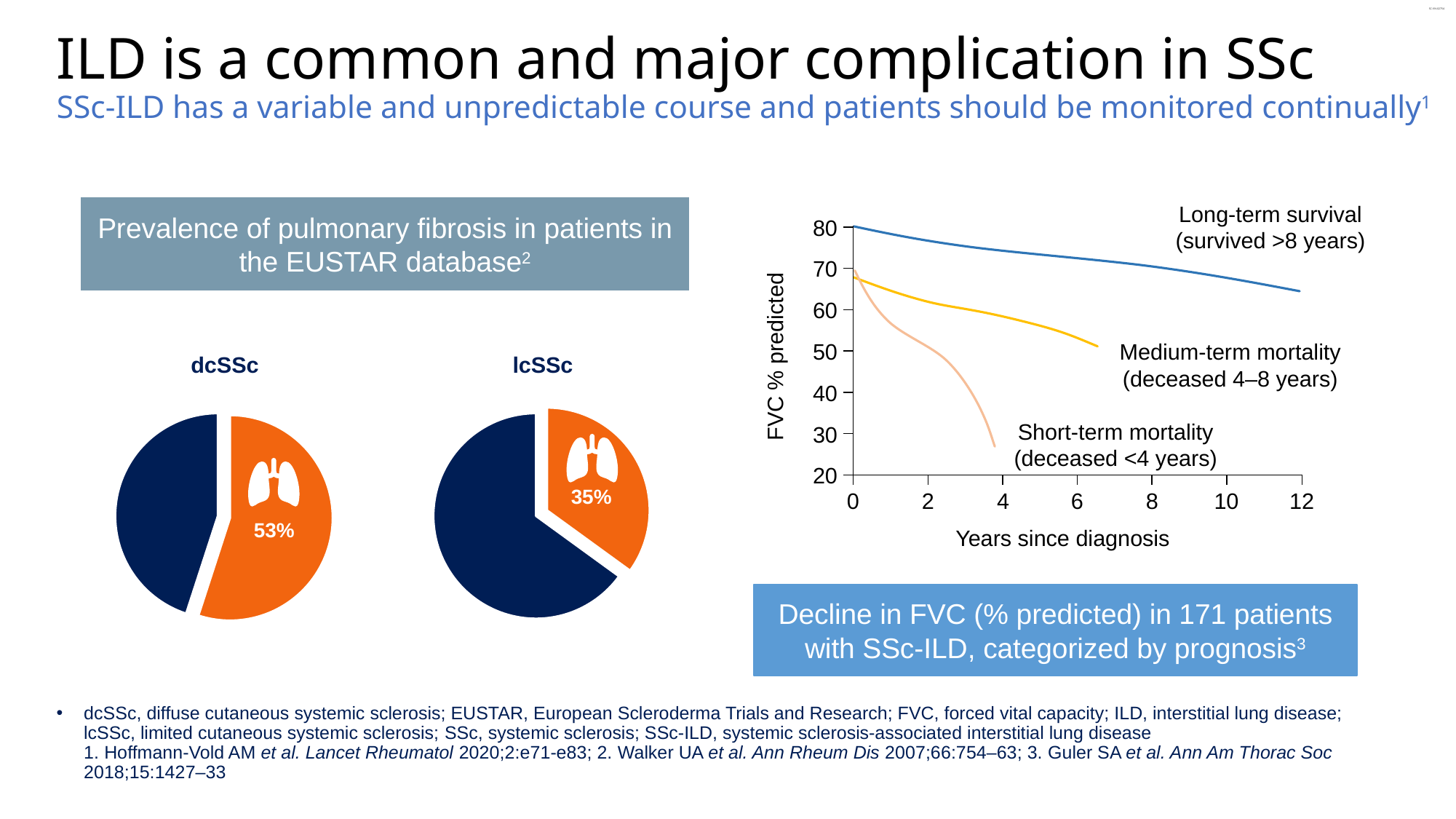
In the lcSSc pie chart, what percentage of patients have pulmonary fibrosis? 35% Which group has the higher prevalence of pulmonary fibrosis in the EUSTAR database pie charts, dcSSc or lcSSc? dcSSc What is the x-axis label of the FVC decline chart? Years since diagnosis How many prognosis groups (curves) are plotted in the FVC decline chart? 3 In the FVC decline chart, which prognosis group has the highest FVC % predicted throughout? Long-term survival (survived >8 years) In the FVC decline chart, is the FVC % predicted for the long-term survival group at 0 years greater or less than 70? greater In the FVC decline chart, do the curves rise or fall as years since diagnosis increase? Fall What kind of chart shows the decline in FVC (% predicted) in patients with SSc-ILD? Line chart In the dcSSc pie chart, what percentage of patients have pulmonary fibrosis? 53% What is the difference in percentage points between the pulmonary fibrosis prevalence in dcSSc and lcSSc? 18 percentage points In the FVC decline chart, is the final plotted value for the short-term mortality group greater or less than 30? less What kind of charts are used to show the prevalence of pulmonary fibrosis in the EUSTAR database? Pie charts